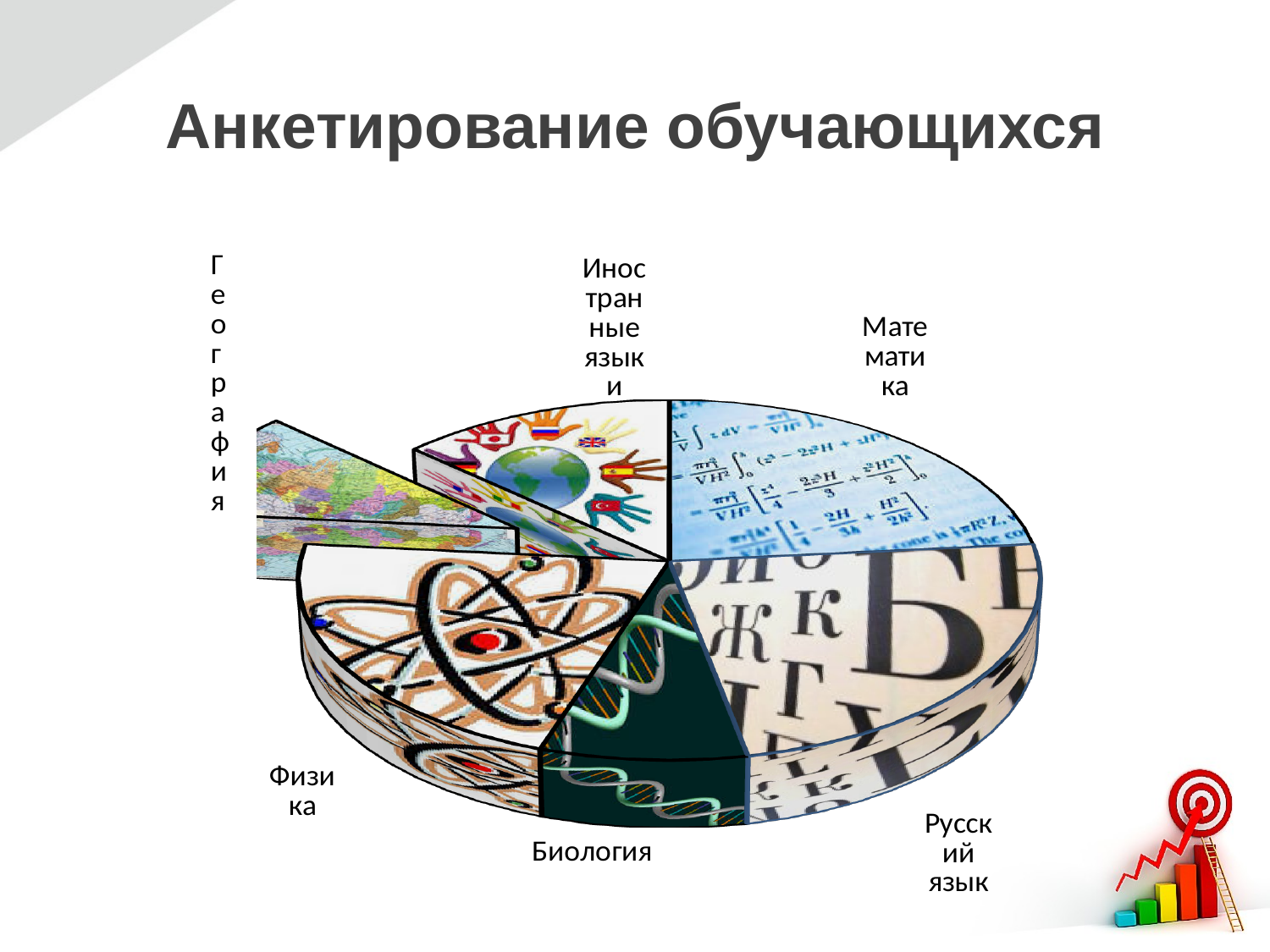
Which slice is larger, Математика or Биология? Математика Which slice is larger, Физика or Иностранные языки? Физика Which slice is larger, Русский язык or Биология? Русский язык What kind of chart is shown on the slide? pie chart Which slice of the pie chart is pulled out (exploded) from the rest of the pie? География What is the title of the slide containing the pie chart? Анкетирование обучающихся How many slices does the pie chart have? 6